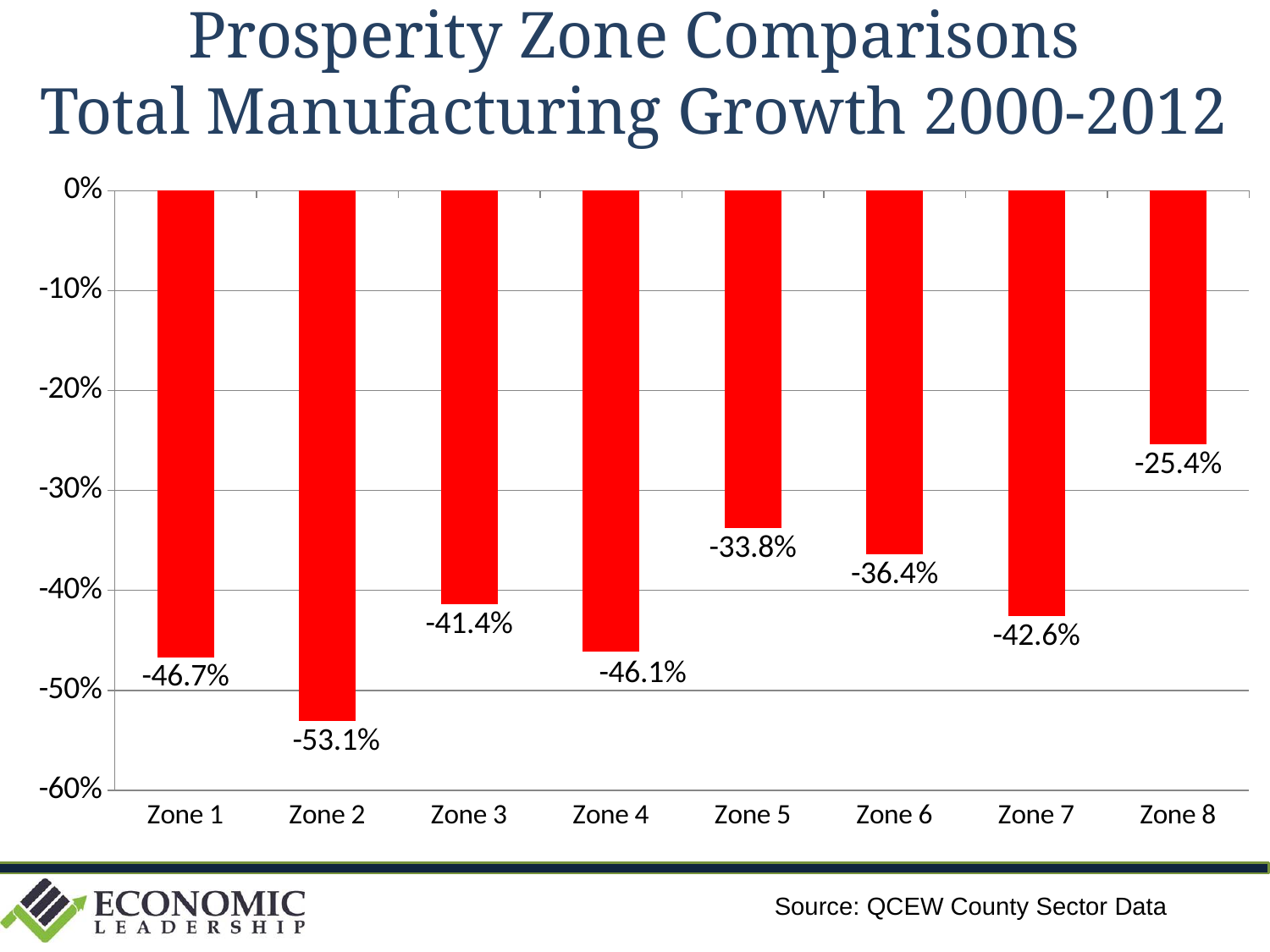
What is the source cited for the chart data? QCEW County Sector Data What kind of chart is shown on the slide? Bar chart Which zone has the lowest (most negative) manufacturing growth? Zone 2 Is the value for Zone 6 greater or less than -40%? greater Which zone has the highest (least negative) manufacturing growth? Zone 8 What colour are the bars in the chart? Red Which zone has a larger (less negative) value, Zone 3 or Zone 7? Zone 3 What is the value shown for Zone 8? -25.4% How many zones are shown on the chart? 8 What is the value shown for Zone 5? -33.8% What is the total manufacturing growth value shown for Zone 2? -53.1% What is the difference between the values for Zone 1 and Zone 4? 0.6 percentage points